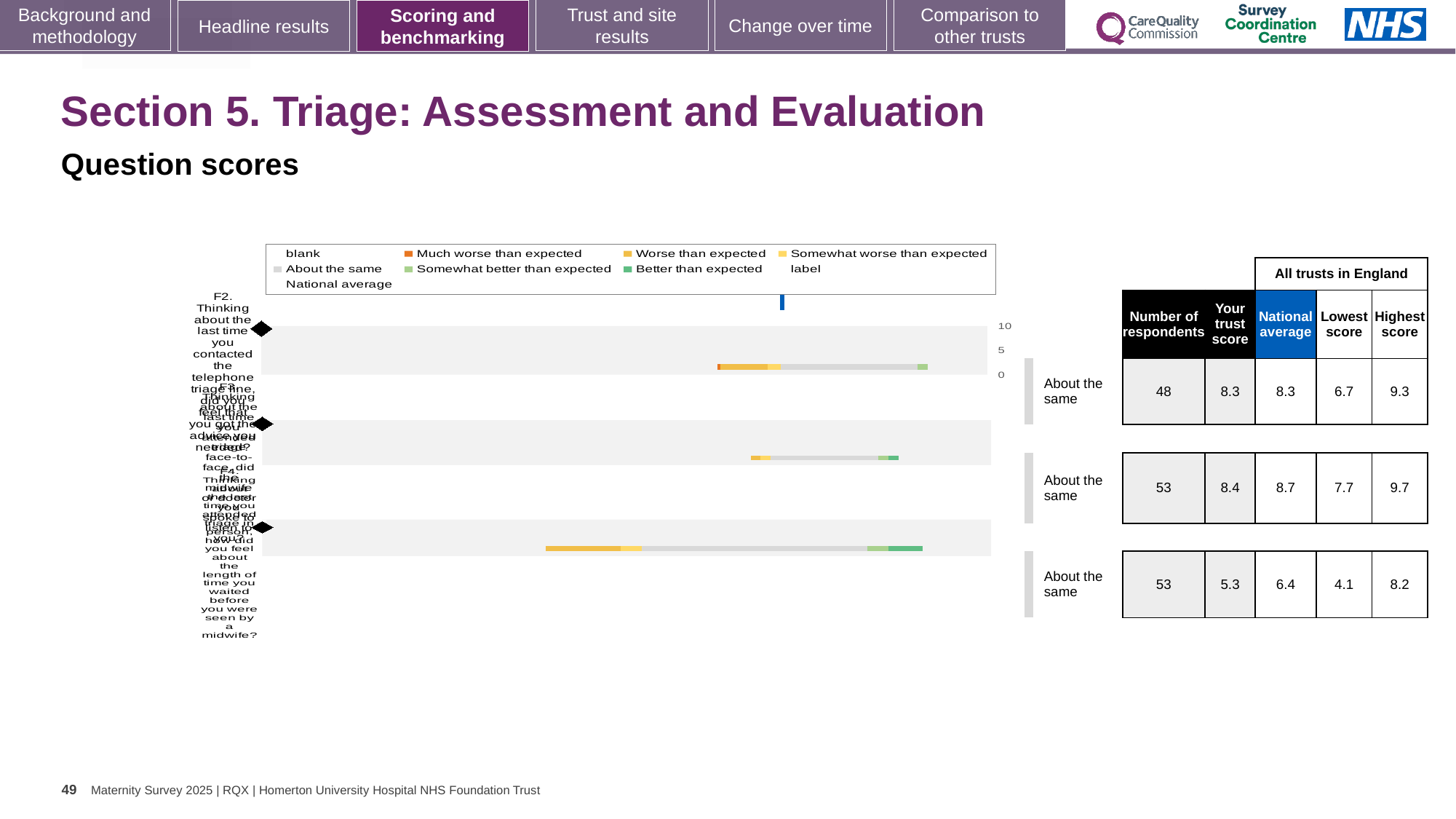
In the table beside the chart, what is the number of respondents for the first row? 48 What is the highest tick value shown on the chart's numeric axis? 10 In the table beside the chart, what benchmark category is given for each of the three rows? About the same In the table beside the chart, what is the trust score for the third row? 5.3 How many question rows are plotted on the chart? 3 Which legend entry is shown in dark orange on the chart? Much worse than expected In the table beside the chart, what is the national average for the second row? 8.7 In the table beside the chart, is the trust score for the second row larger or smaller than its national average? smaller What kind of chart is shown on the slide? bar chart In the table beside the chart, what is the difference between the highest score and the lowest score in the third row? 4.1 In the table beside the chart, which row has the lowest trust score? the third row (5.3)